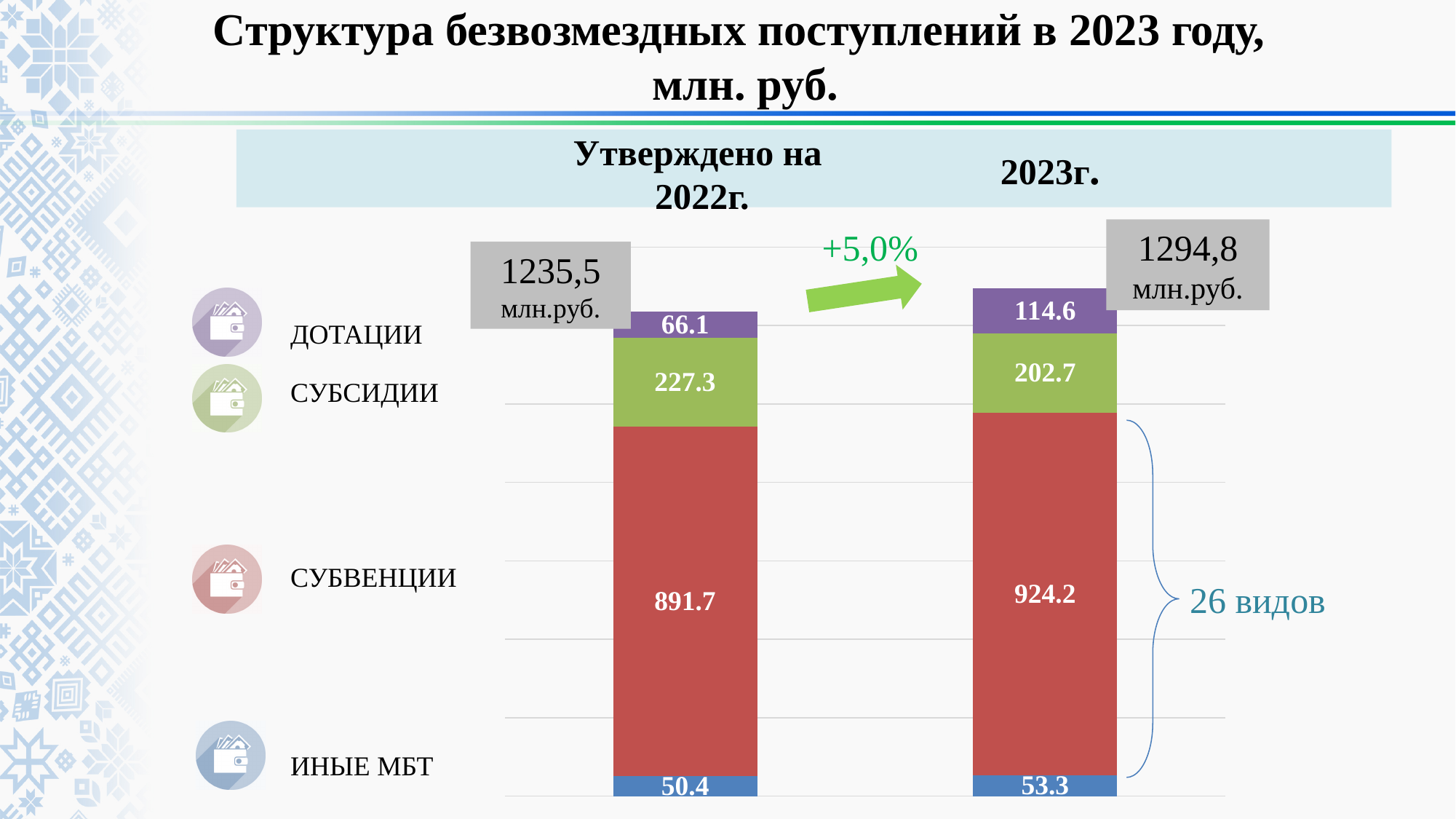
What is the total of the 2023г. stacked bar as labelled on the slide? 1294,8 млн.руб. What percentage change between the two bars is shown next to the arrow? +5,0% What is the difference between the ДОТАЦИИ values for 2023г. and 'Утверждено на 2022г.'? 48.5 What type of chart is shown on the slide? stacked bar chart What is the value of ИНЫЕ МБТ in the bar 'Утверждено на 2022г.'? 50.4 Which is larger: СУБСИДИИ in 'Утверждено на 2022г.' or СУБСИДИИ in 2023г.? Утверждено на 2022г. What is the value of СУБСИДИИ for 2023г.? 202.7 What is the value of СУБВЕНЦИИ for 2023г.? 924.2 How many bars (periods) are shown in the chart? 2 What is the value of ДОТАЦИИ in the bar 'Утверждено на 2022г.'? 66.1 Which component is the largest in the 2023г. bar? СУБВЕНЦИИ Which component is the smallest in the 'Утверждено на 2022г.' bar? ИНЫЕ МБТ